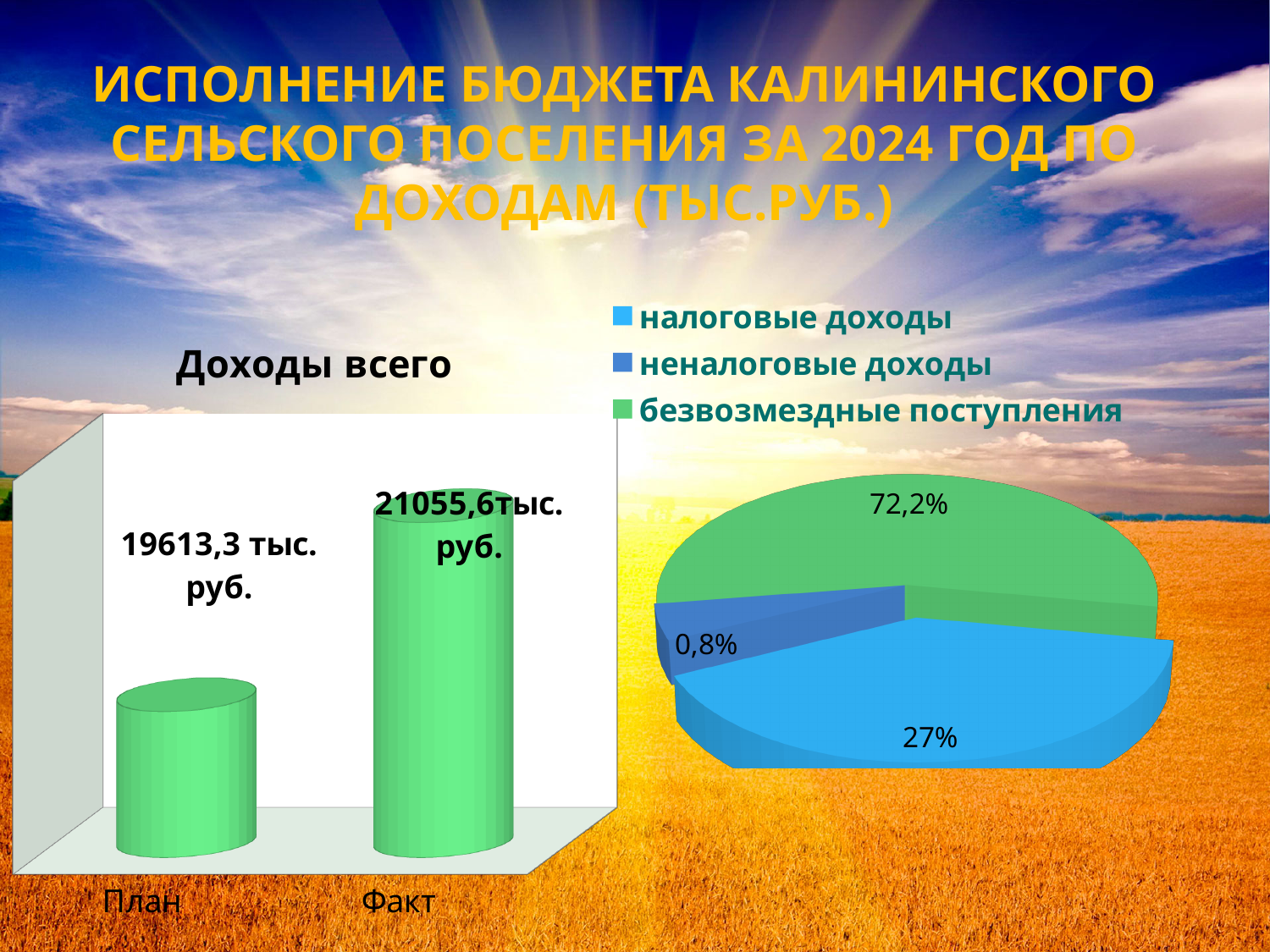
In the pie chart on the right, which category has the largest share? безвозмездные поступления In the pie chart on the right, what share is безвозмездные поступления? 72,2% In the pie chart on the right, what share is неналоговые доходы? 0,8% How many entries does the legend of the pie chart on the right list? 3 In the "Доходы всего" chart, which category has the higher value, План or Факт? Факт In the "Доходы всего" chart, what is the value for План? 19613,3 тыс. руб. In the "Доходы всего" chart, what is the difference between Факт and План? 1442,3 тыс. руб. In the pie chart on the right, what share is налоговые доходы? 27% What kind of chart is the "Доходы всего" chart? Bar chart In the "Доходы всего" chart, how many categories are shown? 2 In the pie chart on the right, which category has the smallest share? неналоговые доходы In the "Доходы всего" chart, what is the value for Факт? 21055,6 тыс. руб.